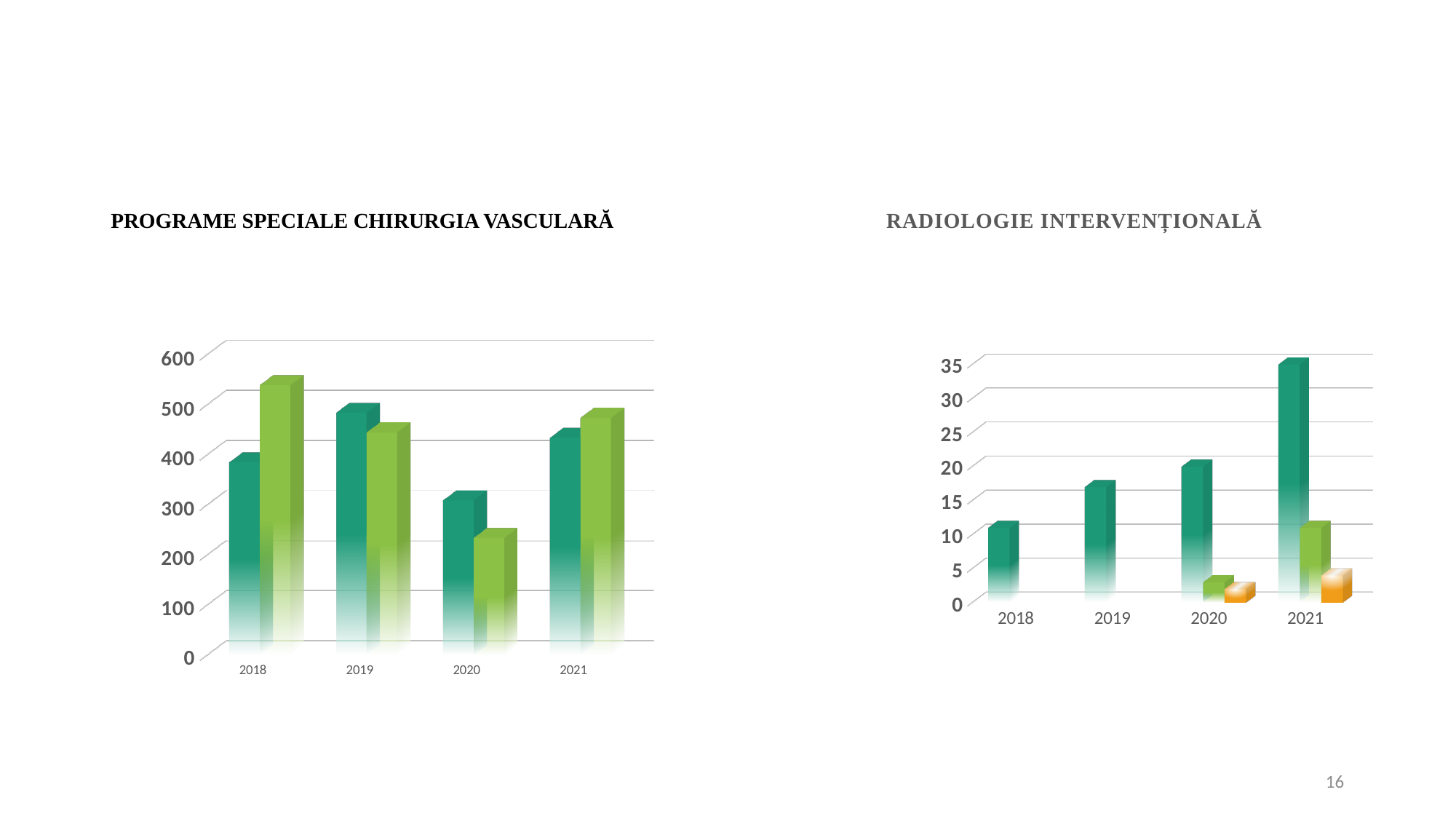
In the PROGRAME SPECIALE CHIRURGIA VASCULARĂ chart, is the dark green bar for 2020 greater or less than 400? less What kind of chart is the PROGRAME SPECIALE CHIRURGIA VASCULARĂ chart? bar chart In the RADIOLOGIE INTERVENȚIONALĂ chart, is the dark green bar for 2021 greater or less than 30? greater In the PROGRAME SPECIALE CHIRURGIA VASCULARĂ chart, which year has the shortest dark green bar? 2020 In the RADIOLOGIE INTERVENȚIONALĂ chart, how many bars are shown for 2021? 3 In the RADIOLOGIE INTERVENȚIONALĂ chart, do the dark green bars rise or fall from 2018 to 2021? rise In the PROGRAME SPECIALE CHIRURGIA VASCULARĂ chart, is the light green bar for 2018 greater or less than 500? greater How many years are shown on the x axis of the PROGRAME SPECIALE CHIRURGIA VASCULARĂ chart? 4 How many years are shown on the x axis of the RADIOLOGIE INTERVENȚIONALĂ chart? 4 In the PROGRAME SPECIALE CHIRURGIA VASCULARĂ chart, for 2018, which bar is taller: the dark green or the light green? light green In the RADIOLOGIE INTERVENȚIONALĂ chart, which year has the tallest dark green bar? 2021